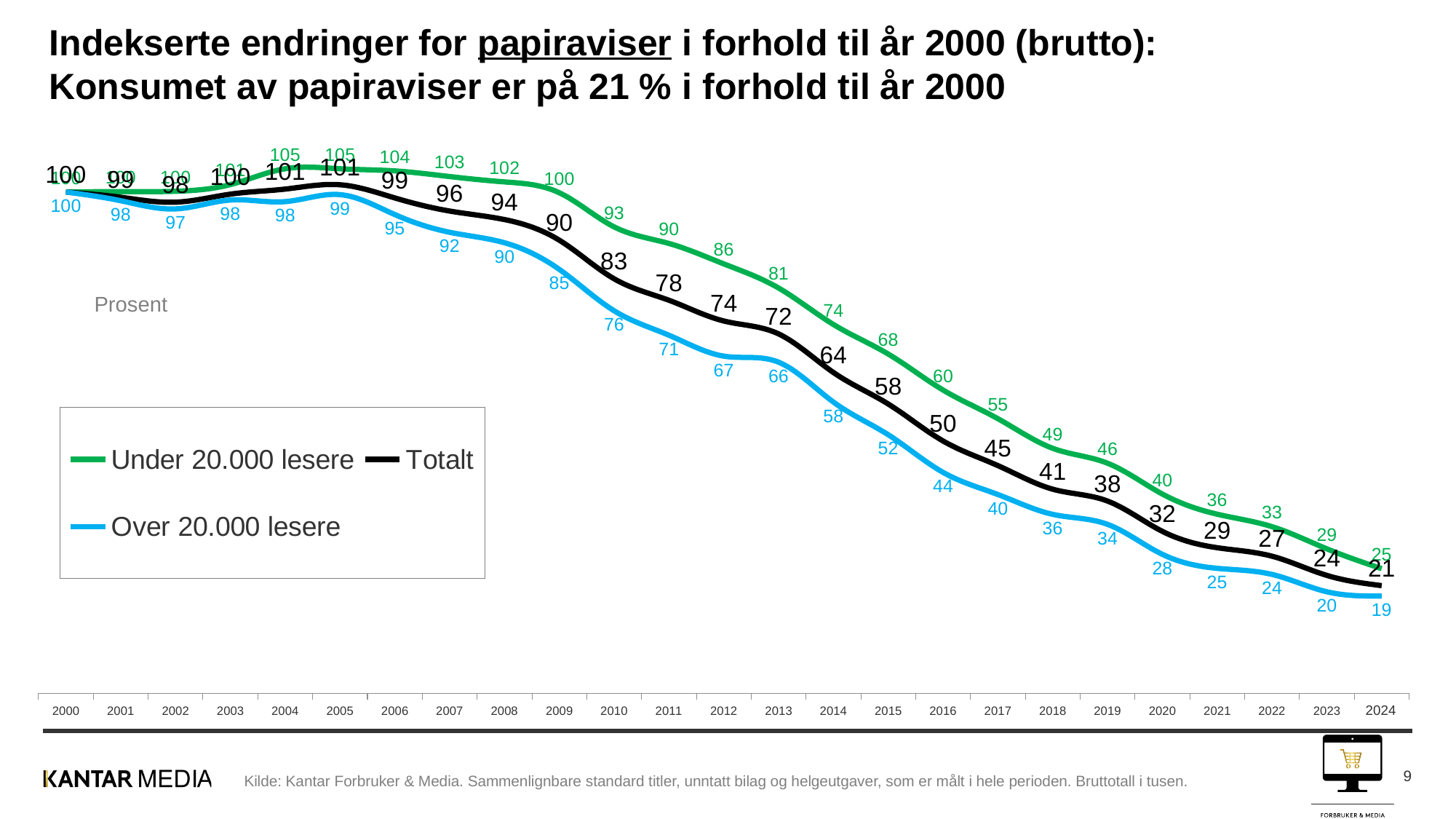
Do the values for Totalt rise or fall from 2009 to 2024? fall Which series has the higher value in 2015, Totalt or Over 20.000 lesere? Totalt What is the highest value shown for the Under 20.000 lesere series? 105 What is the value for Over 20.000 lesere in 2016? 44 What kind of chart is shown on the slide? line chart In which year does the Over 20.000 lesere series reach its lowest value? 2024 How many years are shown on the x axis? 25 What is the value for Totalt in 2013? 72 What is the difference between Under 20.000 lesere and Over 20.000 lesere in 2020? 12 How many series does the legend list? 3 What is the value for Under 20.000 lesere in 2010? 93 What is the value for Totalt in 2024? 21